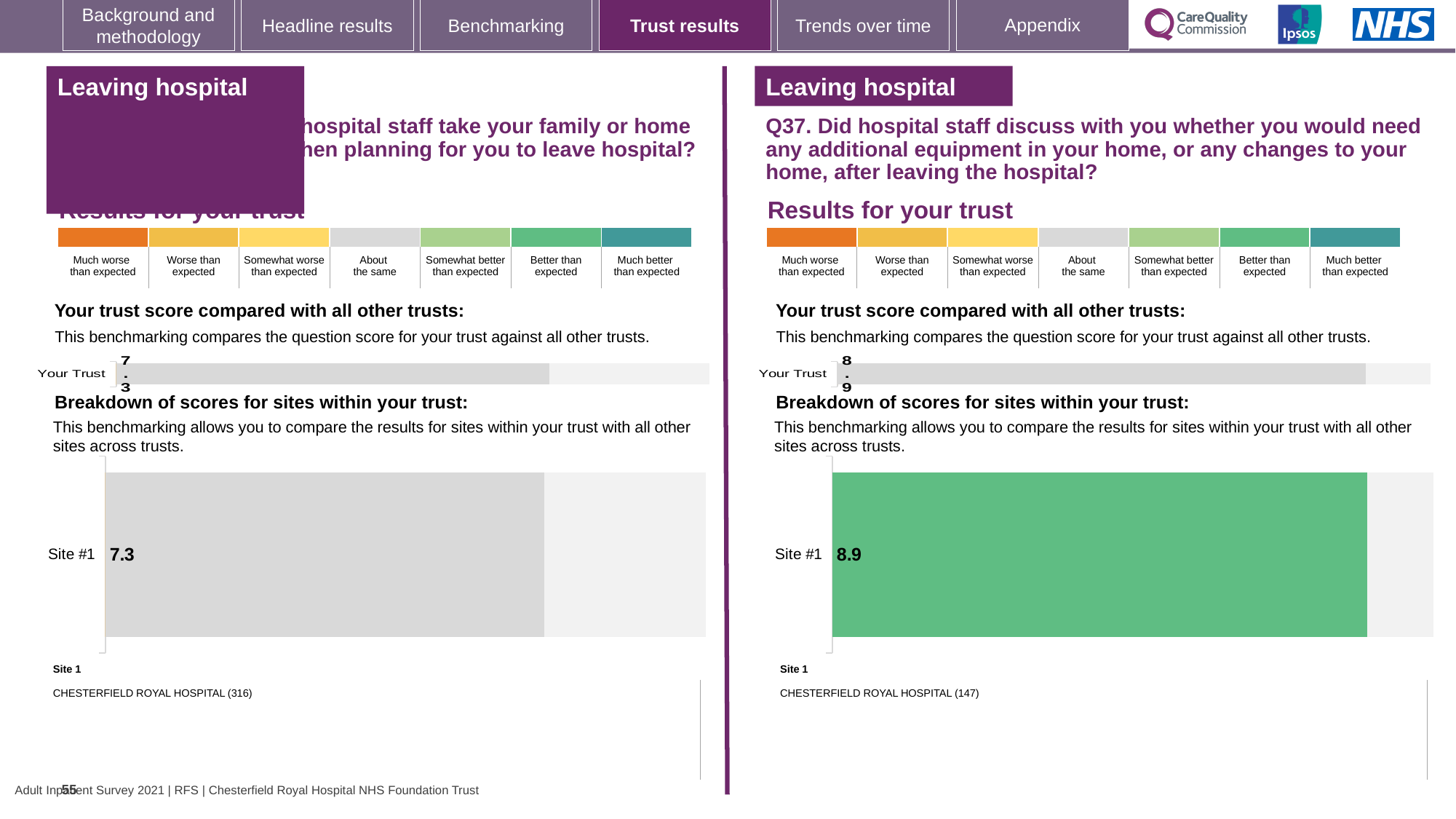
How many sites are shown in the 'Breakdown of scores for sites within your trust' chart on the right half of the slide? 1 On the left half of the slide, what is the 'Your Trust' score in the trust benchmarking bar? 7.3 What is the difference between the Site #1 score on the right half (Q37) and the Site #1 score on the left half of the slide? 1.6 What colour is the Site #1 bar on the right half of the slide (Q37)? Green On the right half of the slide (Q37), what is the 'Your Trust' score in the trust benchmarking bar? 8.9 On the left half of the slide, what is the score shown for Site #1? 7.3 What is the name of Site 1 listed below the site breakdown chart on the right half of the slide? CHESTERFIELD ROYAL HOSPITAL (147) What type of chart is used to show the Site #1 score on the left half of the slide? Bar chart Which Site #1 score is larger: the one on the left half of the slide or the one on the right half (Q37)? The right half (Q37), 8.9 How many sites are shown in the 'Breakdown of scores for sites within your trust' chart on the left half of the slide? 1 On the right half of the slide (Q37), what is the score shown for Site #1? 8.9